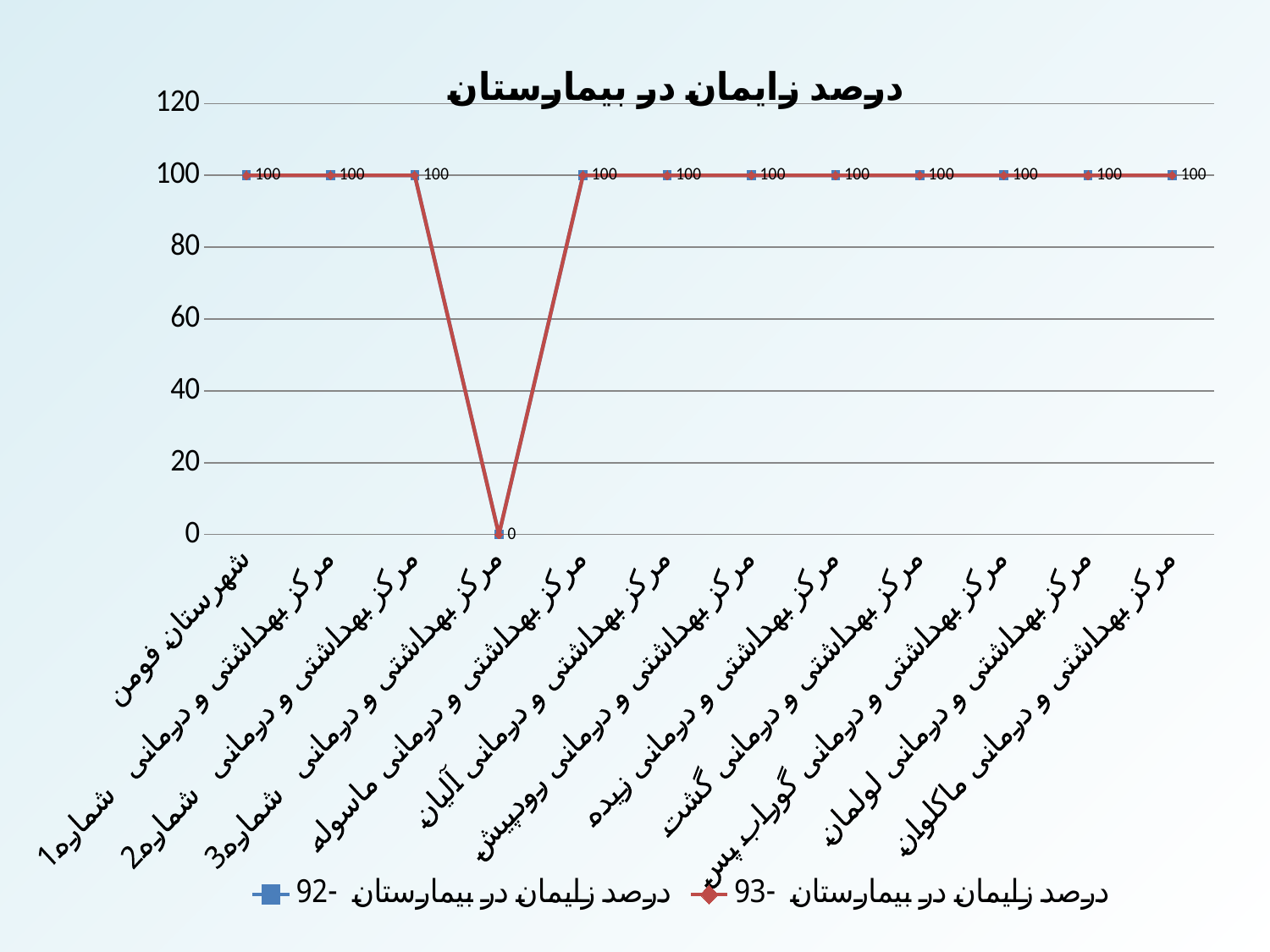
What is the value for شهرستان فومن? 100 What is the value for مرکز بهداشتی و درمانی ماکلوان? 100 How many categories are shown on the x axis? 12 Which is larger, the value for مرکز بهداشتی و درمانی گشت or the value for مرکز بهداشتی و درمانی ماسوله? Neither; both are 100 Is the value for مرکز بهداشتی و درمانی لولمان greater or less than 80? greater What is the difference between the value for مرکز بهداشتی و درمانی آلیان and the value for مرکز بهداشتی و درمانی ماسوله? 0 What type of chart is shown on the slide? line chart How many series does the legend list? 2 What is the value for مرکز بهداشتی و درمانی ماسوله? 100 Which category has the lowest value? مرکز بهداشتی و درمانی شماره 3 What is the title of the chart? درصد زایمان در بیمارستان What is the maximum value shown on the y axis? 120